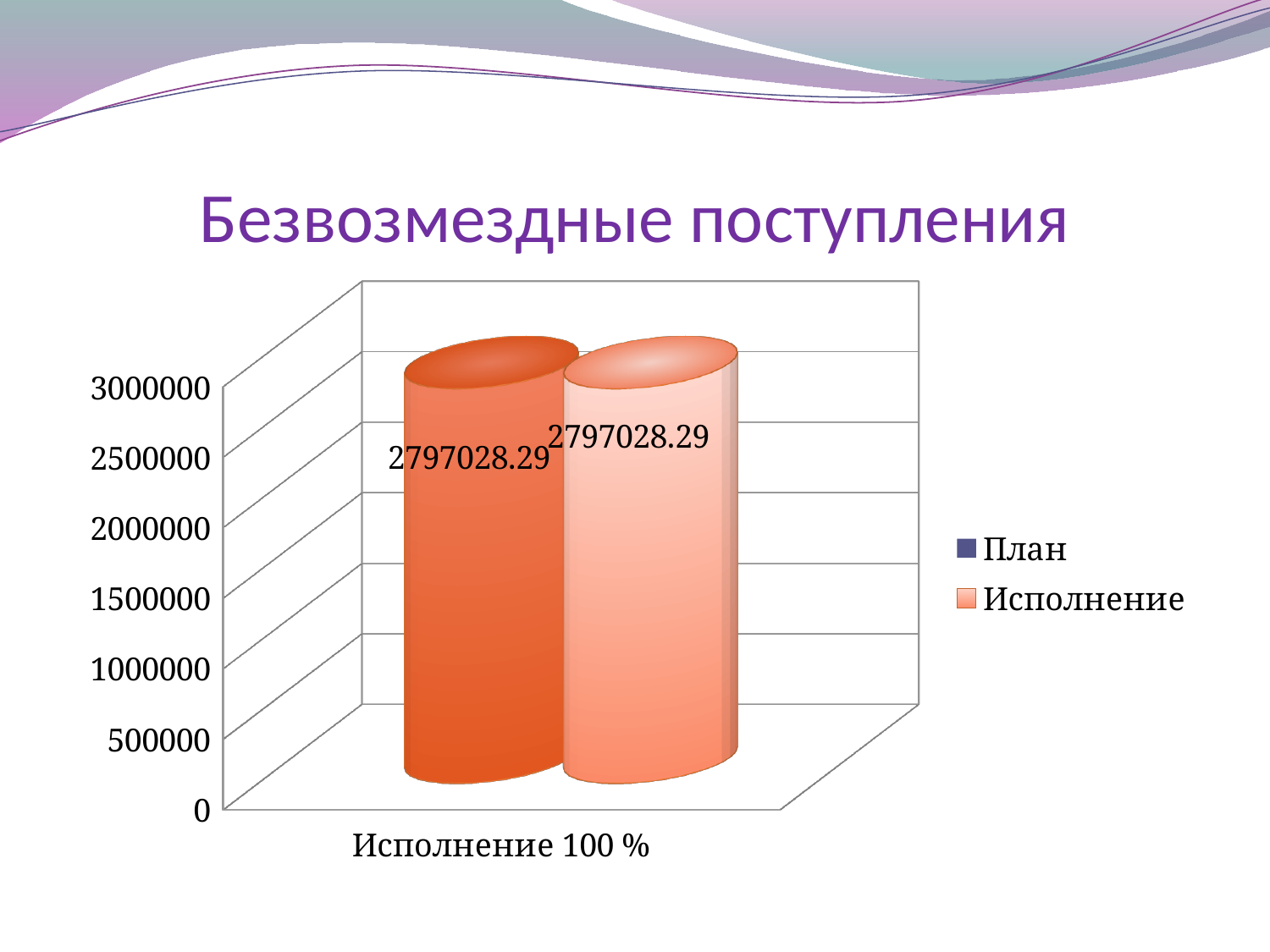
What is the value of the План series on the chart? 2797028.29 What is the label of the category on the x axis? Исполнение 100 % What is the highest value shown on the vertical axis? 3000000 Is the value for Исполнение greater or less than 3000000? less Is the value for План greater or less than 2500000? greater How many categories are shown on the x axis? 1 What is the difference between the План and Исполнение values? 0 What kind of chart is shown on the slide? bar chart What is the value of the Исполнение series on the chart? 2797028.29 How many series does the legend list? 2 What is the title of the chart? Безвозмездные поступления